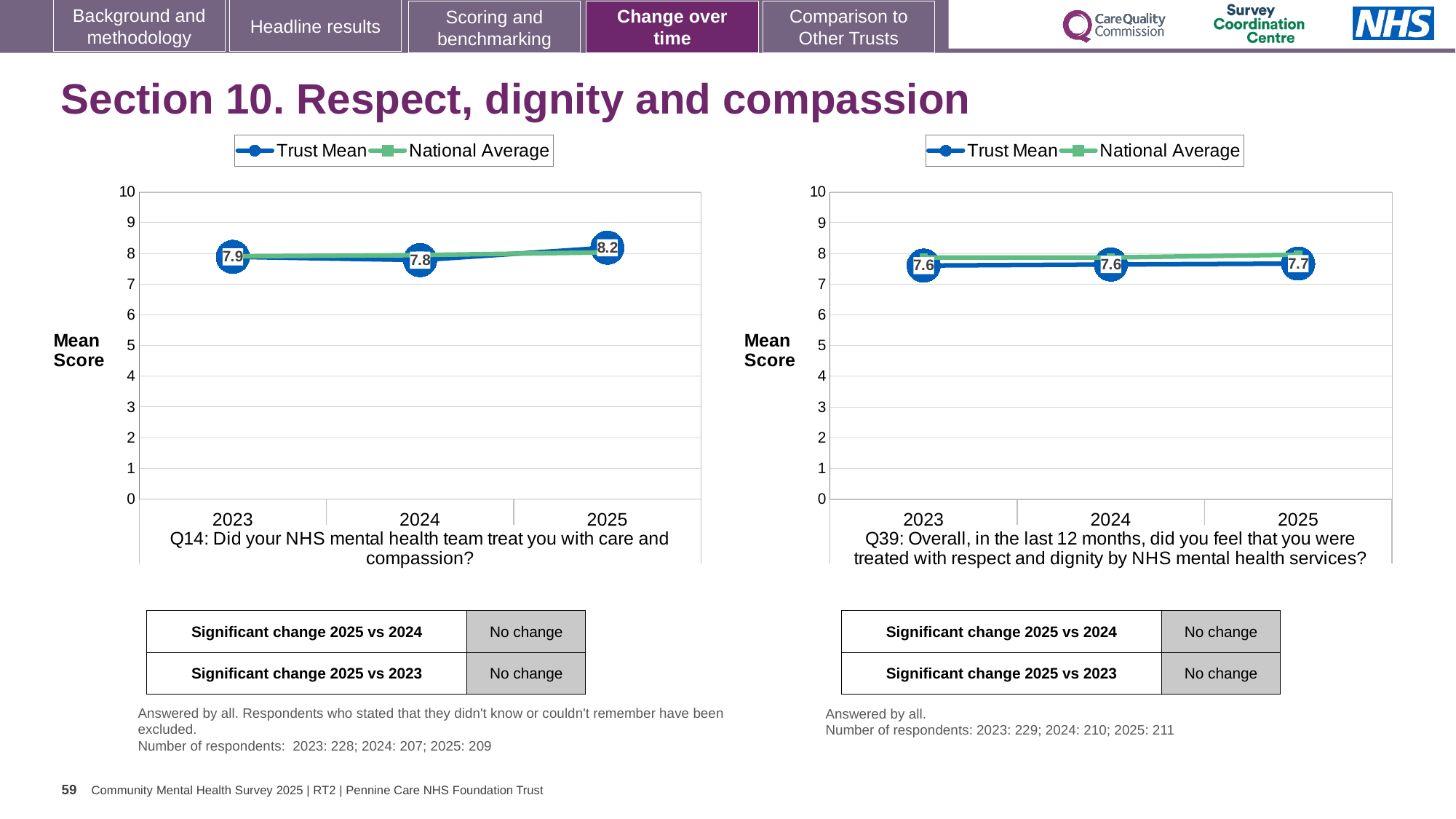
In the Q14 chart (left), what is the difference between the Trust Mean scores for 2025 and 2024? 0.4 How many series does the legend of the Q39 chart (right) list? 2 In the Q14 chart (left), what is the Trust Mean score for 2023? 7.9 In the Q14 chart (left), what is the Trust Mean score for 2025? 8.2 In the Q39 chart (right), what is the Trust Mean score for 2025? 7.7 What type of chart is the Q14 chart (left)? Line chart In the Q39 chart (right), which is larger, the Trust Mean for 2023 or the Trust Mean for 2025? 2025 In the Q39 chart (right), what is the Trust Mean score for 2024? 7.6 How many years are plotted on the x axis of the Q14 chart (left)? 3 In the Q14 chart (left), which year has the highest Trust Mean score? 2025 In the Q14 chart (left), which year has the lowest Trust Mean score? 2024 In the Q39 chart (right), is the Trust Mean score for 2023 greater or less than 8? less